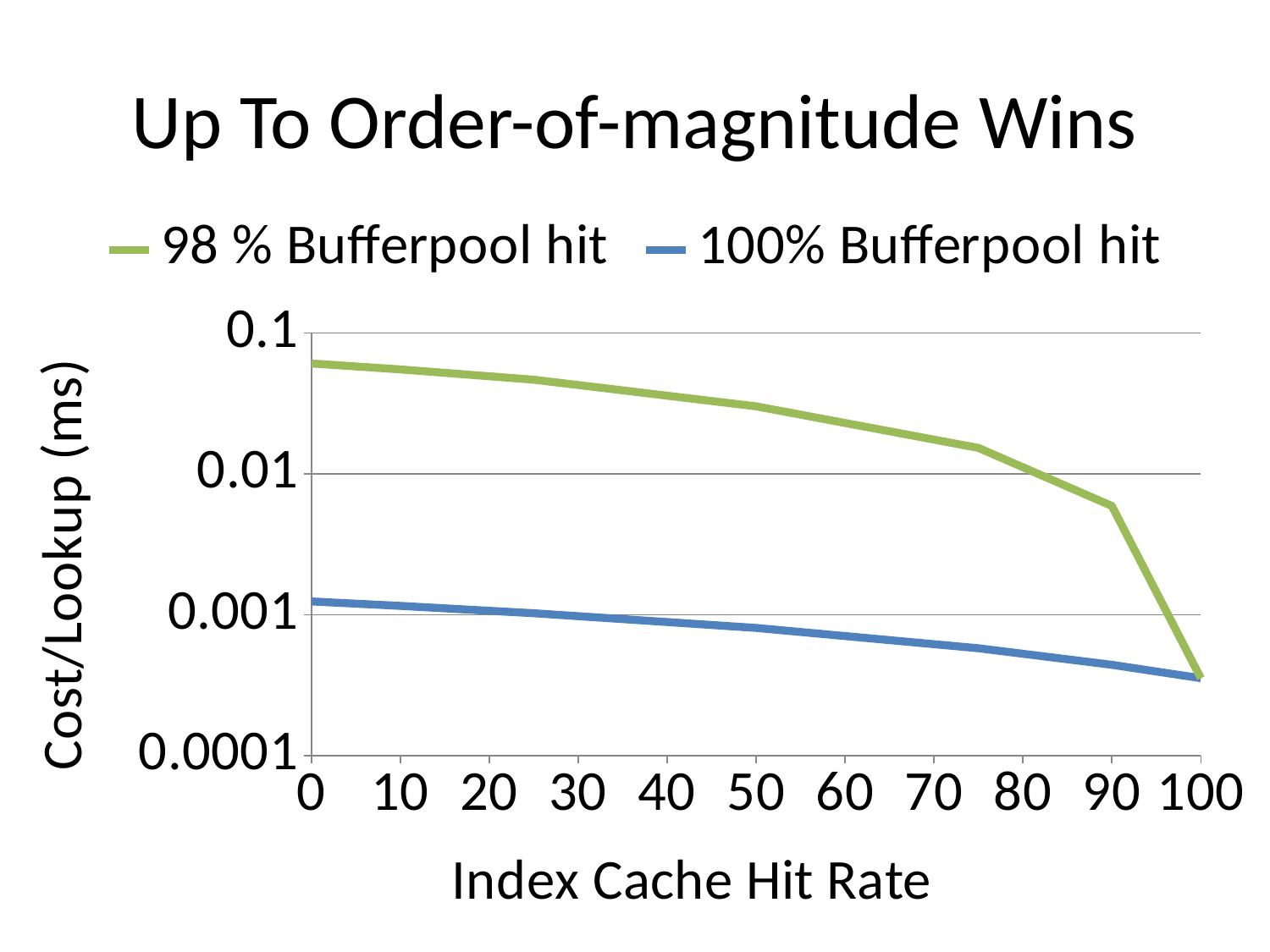
What is the label of the x axis? Index Cache Hit Rate Is the value for 98 % Bufferpool hit at an Index Cache Hit Rate of 90 greater or less than 0.01? less Does the 98 % Bufferpool hit series rise or fall as Index Cache Hit Rate increases? fall Is the value for 98 % Bufferpool hit at an Index Cache Hit Rate of 0 greater or less than 0.01? greater What kind of chart is shown on the slide? line chart How many series does the legend list? 2 Is the value for 98 % Bufferpool hit at an Index Cache Hit Rate of 50 greater or less than 0.01? greater What is the title of the chart? Up To Order-of-magnitude Wins At an Index Cache Hit Rate of 50, which series has the higher Cost/Lookup: 98 % Bufferpool hit or 100% Bufferpool hit? 98 % Bufferpool hit At which Index Cache Hit Rate does the 98 % Bufferpool hit series reach its lowest value? 100 Does the 100% Bufferpool hit series rise or fall as Index Cache Hit Rate increases? fall